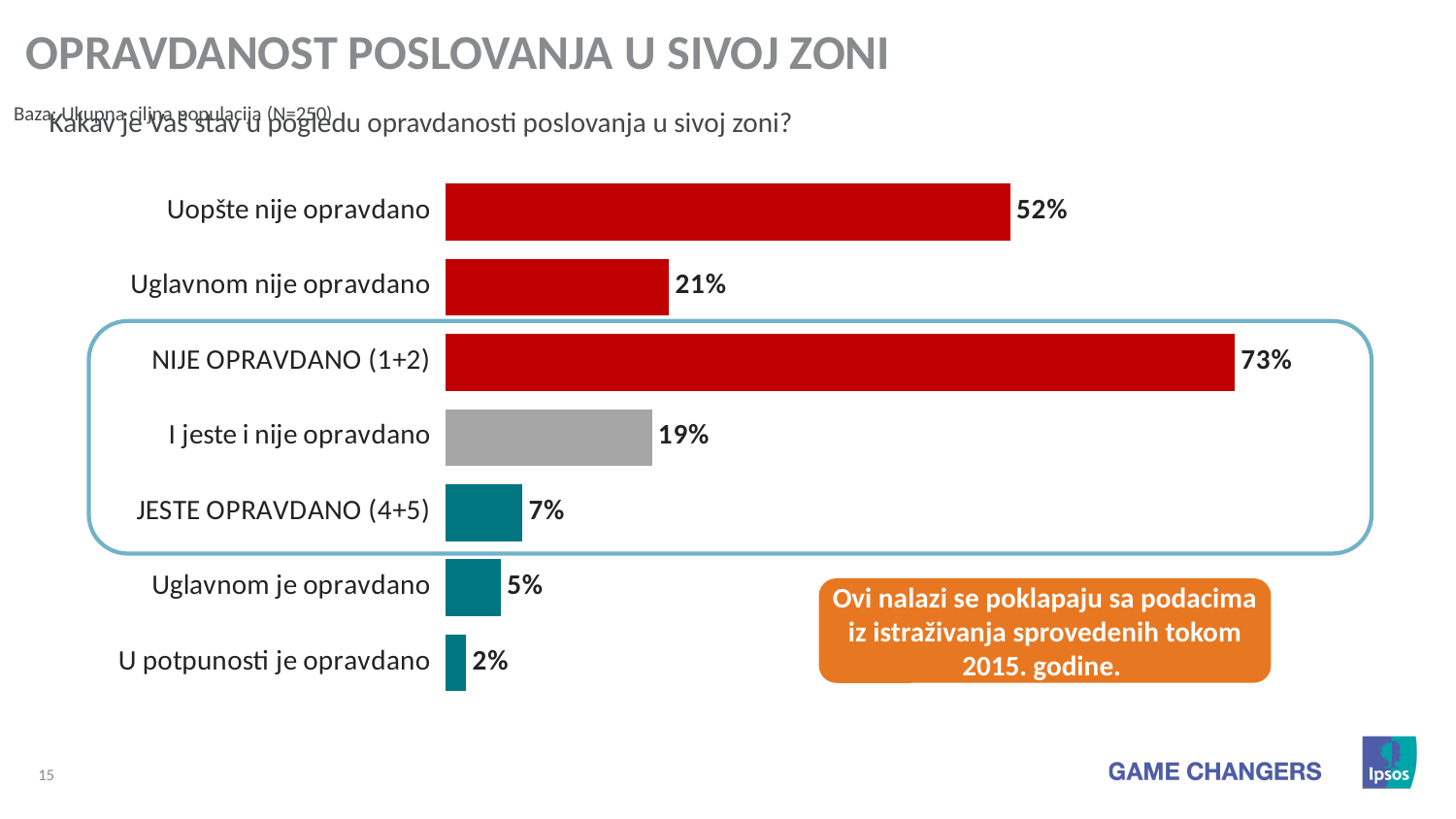
Which is larger, "JESTE OPRAVDANO (4+5)" or "Uglavnom je opravdano"? JESTE OPRAVDANO (4+5) What is the value for "Uopšte nije opravdano"? 52% Which category has the lowest value? U potpunosti je opravdano What is the difference between "Uopšte nije opravdano" and "Uglavnom nije opravdano"? 31% How many categories are shown in the chart? 7 What is the value for "I jeste i nije opravdano"? 19% What is the value for "NIJE OPRAVDANO (1+2)"? 73% What is the value for "U potpunosti je opravdano"? 2% What kind of chart is shown on the slide? Bar chart What is the value for "Uglavnom nije opravdano"? 21% Which category has the highest value? NIJE OPRAVDANO (1+2) What colour is the bar for "I jeste i nije opravdano"? Grey